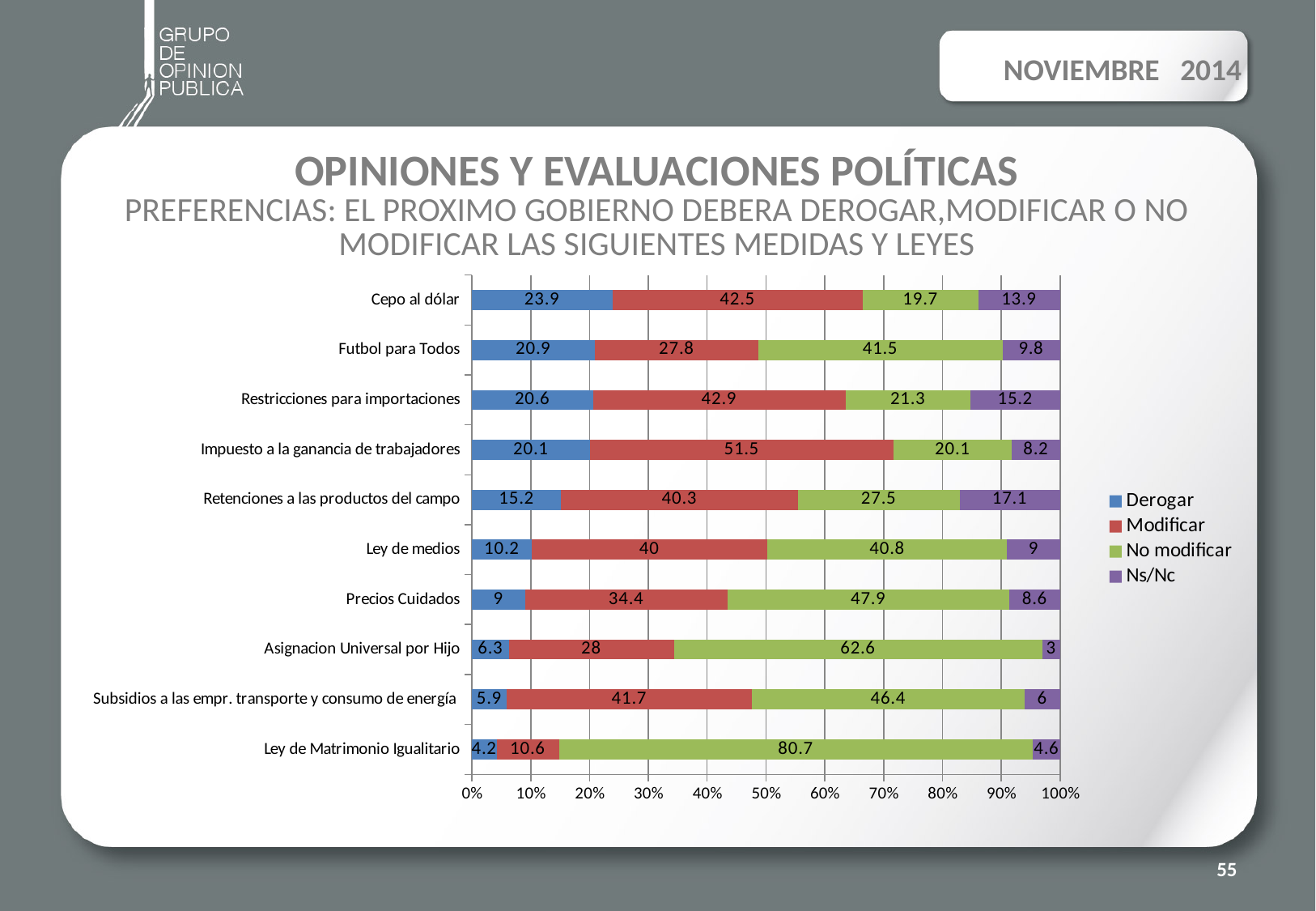
What is the difference between the Modificar values for Cepo al dólar and Futbol para Todos? 14.7 What is the No modificar value for Ley de Matrimonio Igualitario? 80.7 Which category has the lowest Derogar value? Ley de Matrimonio Igualitario What is the Ns/Nc value for Retenciones a las productos del campo? 17.1 Which category has the highest Modificar value? Impuesto a la ganancia de trabajadores What is the Derogar value for Cepo al dólar? 23.9 How many series does the legend list? 4 Which has a larger No modificar value, Precios Cuidados or Subsidios a las empr. transporte y consumo de energía? Precios Cuidados What colour represents the Modificar series in the legend? Red What kind of chart is shown on the slide? Stacked bar chart What is the total of the four values for Asignacion Universal por Hijo? 99.9 How many categories (measures and laws) are shown in the chart? 10